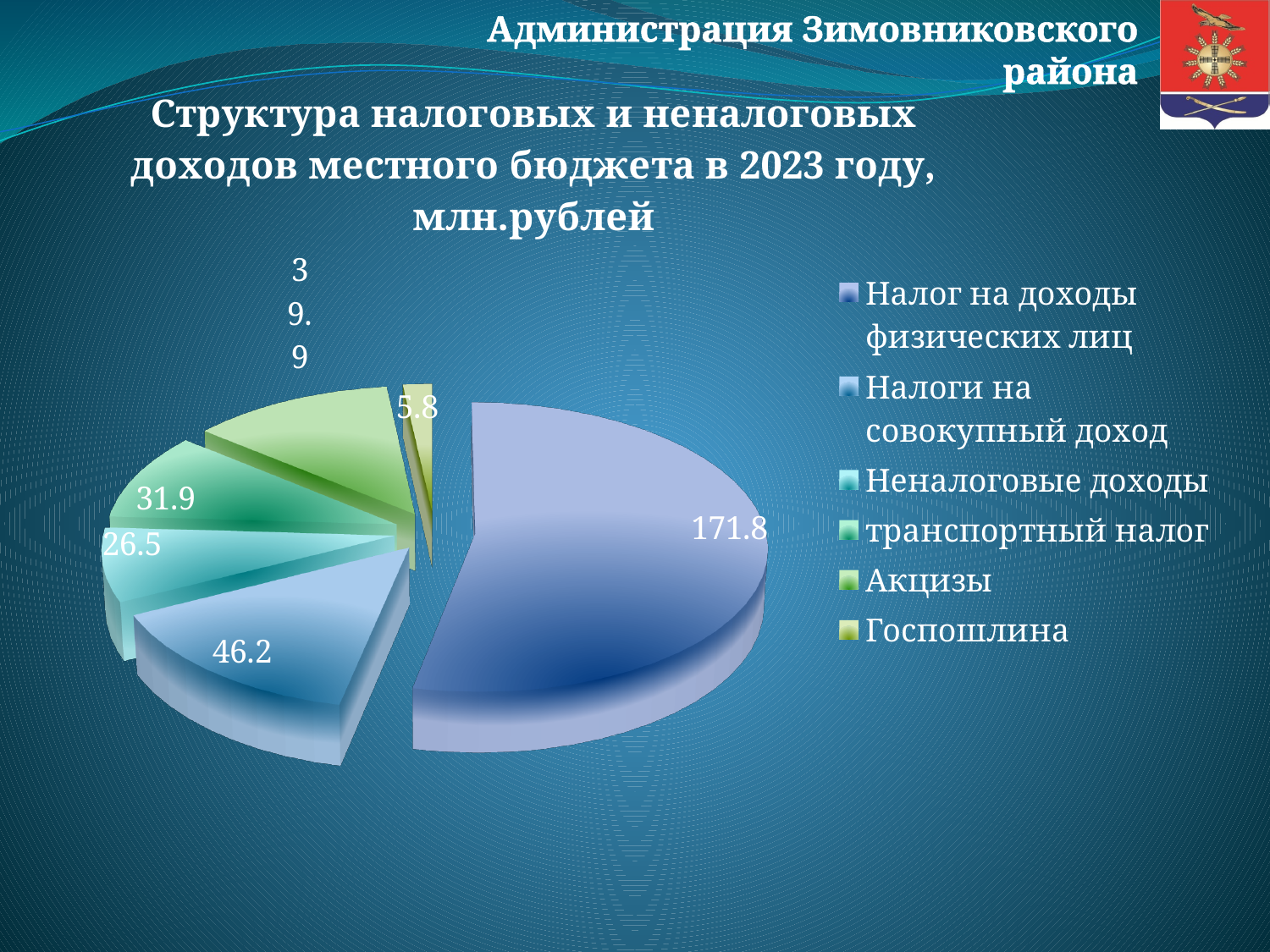
How many entries does the legend list? 6 What is the value for Налоги на совокупный доход? 46.2 What is the value for Неналоговые доходы? 26.5 What is the value for транспортный налог? 31.9 What is the value for Налог на доходы физических лиц? 171.8 Which is larger, транспортный налог or Неналоговые доходы? транспортный налог How many slices does the pie chart have? 6 Which category has the largest slice? Налог на доходы физических лиц What kind of chart is shown on the slide? pie chart Which category has the smallest slice? Госпошлина What is the difference between Налог на доходы физических лиц and Налоги на совокупный доход? 125.6 What is the value for Госпошлина? 5.8